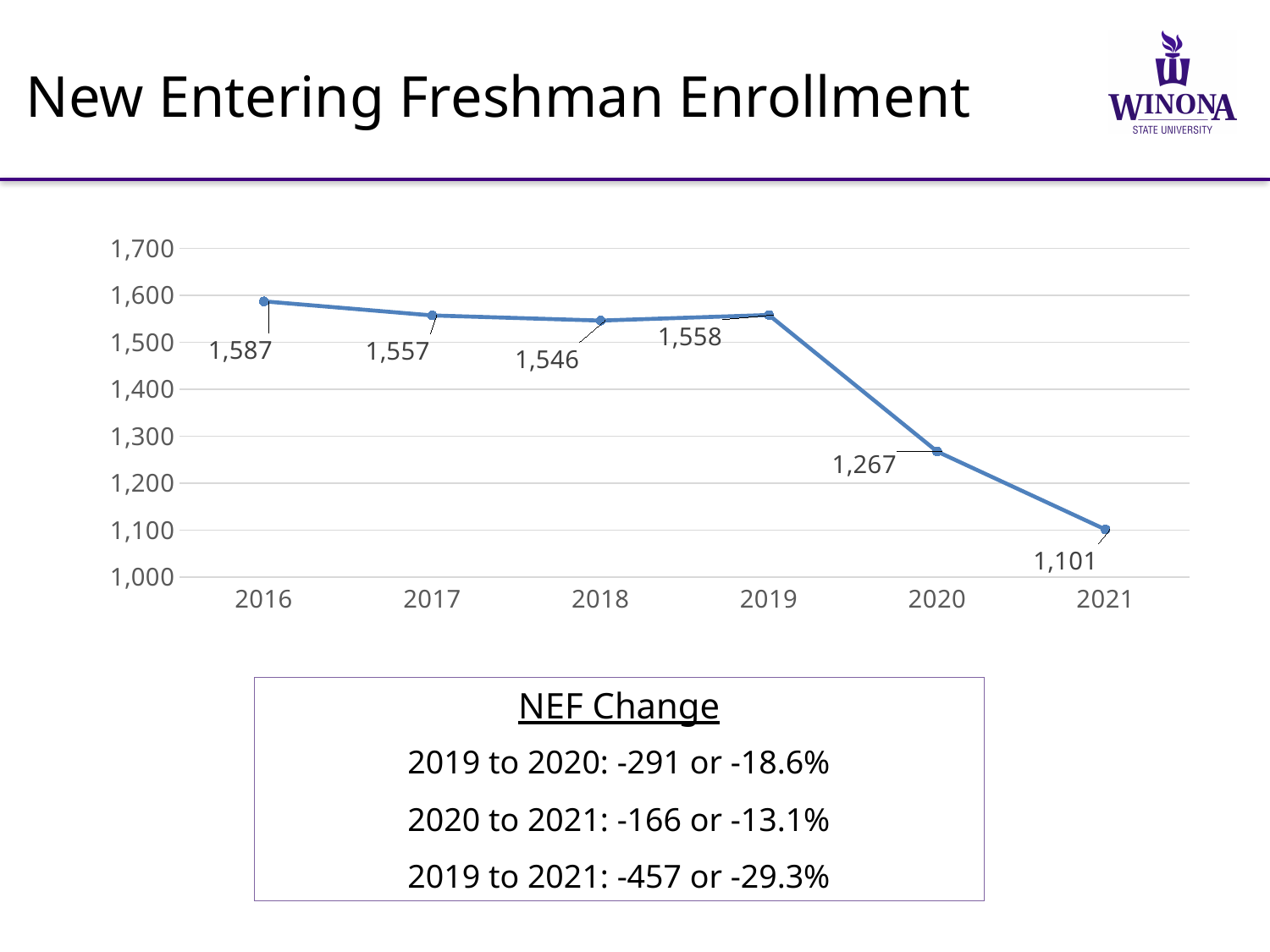
Which year had the lowest new entering freshman enrollment? 2021 What was the new entering freshman enrollment in 2016? 1,587 Which year had higher enrollment, 2018 or 2019? 2019 Is the enrollment value for 2020 greater or less than 1,300? less What kind of chart is shown on the slide? line chart How many years are plotted on the chart? 6 What was the new entering freshman enrollment in 2020? 1,267 Which year had the highest new entering freshman enrollment? 2016 What is the difference in enrollment between 2019 and 2020? 291 What is the difference in enrollment between 2016 and 2021? 486 What was the new entering freshman enrollment in 2021? 1,101 Does enrollment rise or fall from 2019 to 2021? fall